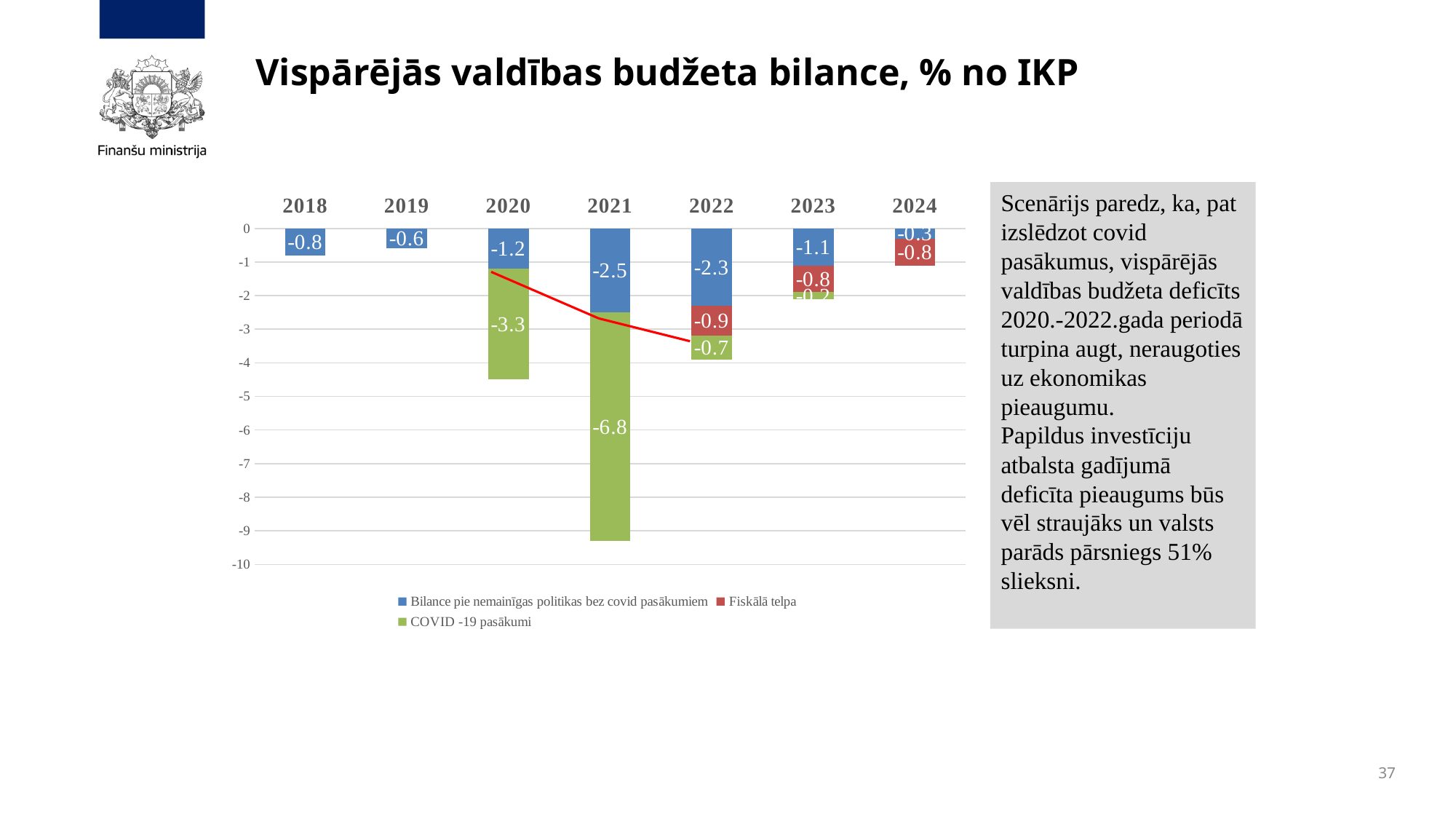
In which year is the 'COVID -19 pasākumi' value the most negative? 2021 What kind of chart is shown on the slide? Stacked bar chart What is the difference between the 'COVID -19 pasākumi' values for 2021 and 2020? 3.5 What is the value of 'Bilance pie nemainīgas politikas bez covid pasākumiem' for 2018? -0.8 Which is more negative: 'Bilance pie nemainīgas politikas bez covid pasākumiem' in 2020 or in 2022? 2022 What is the value of 'COVID -19 pasākumi' for 2020? -3.3 How many years are shown on the x axis? 7 What is the value of 'Bilance pie nemainīgas politikas bez covid pasākumiem' for 2021? -2.5 What is the total of the stacked bar for 2021? -9.3 What is the value of 'Fiskālā telpa' for 2022? -0.9 How many series does the legend list? 3 In which year is the 'Bilance pie nemainīgas politikas bez covid pasākumiem' value the most negative? 2021